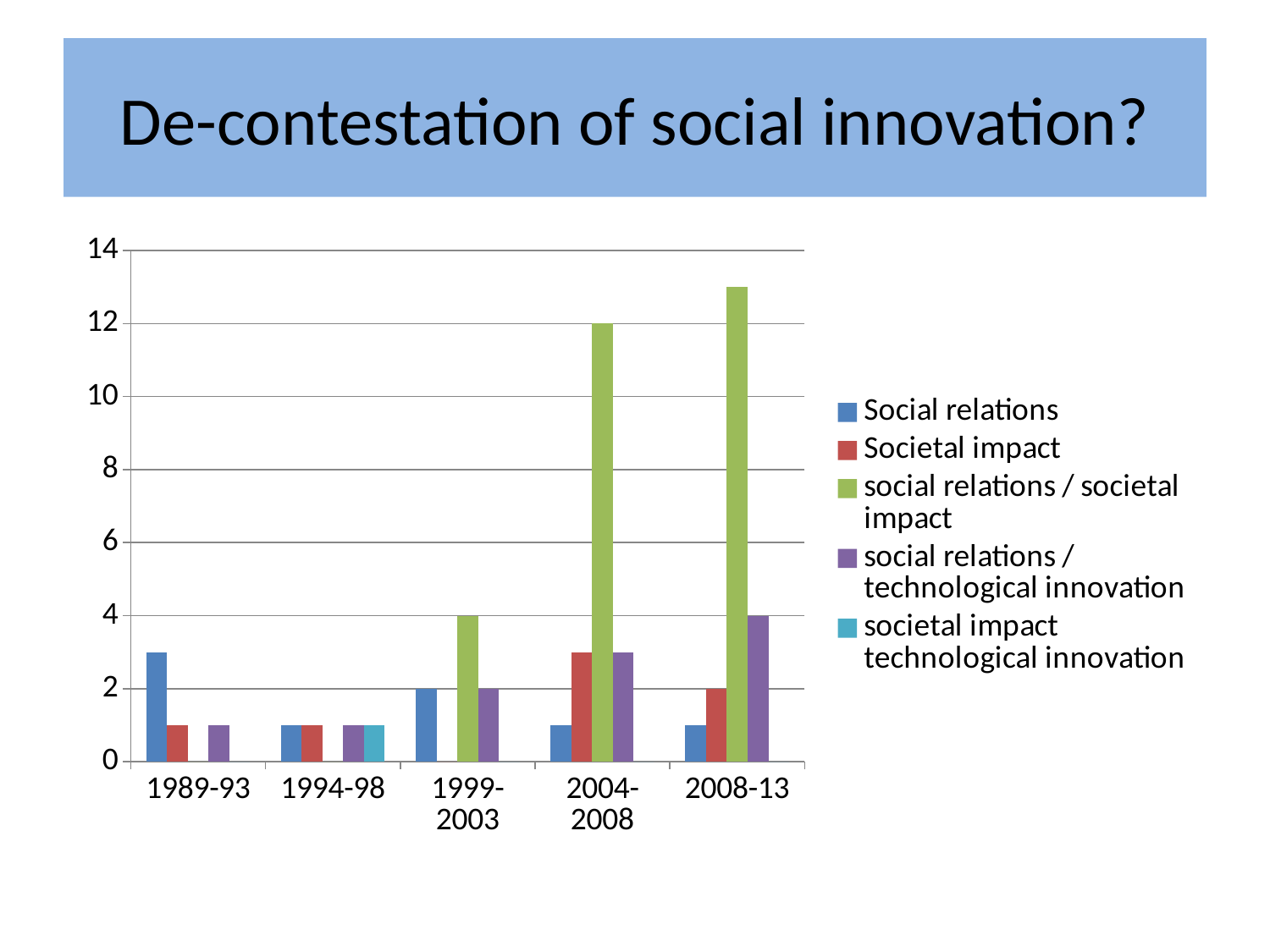
What is the value for 'social relations / societal impact' in 1999-2003? 4 In which period is the 'social relations / societal impact' bar highest? 2008-13 How many series does the legend list? 5 How many time periods are shown on the x axis? 5 What is the value for 'social relations / societal impact' in 2004-2008? 12 Is the value for 'Social relations' in 1989-93 greater or less than 2? greater What is the value for 'Social relations' in 1999-2003? 2 What is the difference between the 'social relations / societal impact' values in 2004-2008 and 1999-2003? 8 What is the value for 'social relations / technological innovation' in 2008-13? 4 Is the value for 'social relations / societal impact' in 2008-13 greater or less than 12? greater What kind of chart is shown on the slide? Bar chart What is the title of the slide containing the chart? De-contestation of social innovation?